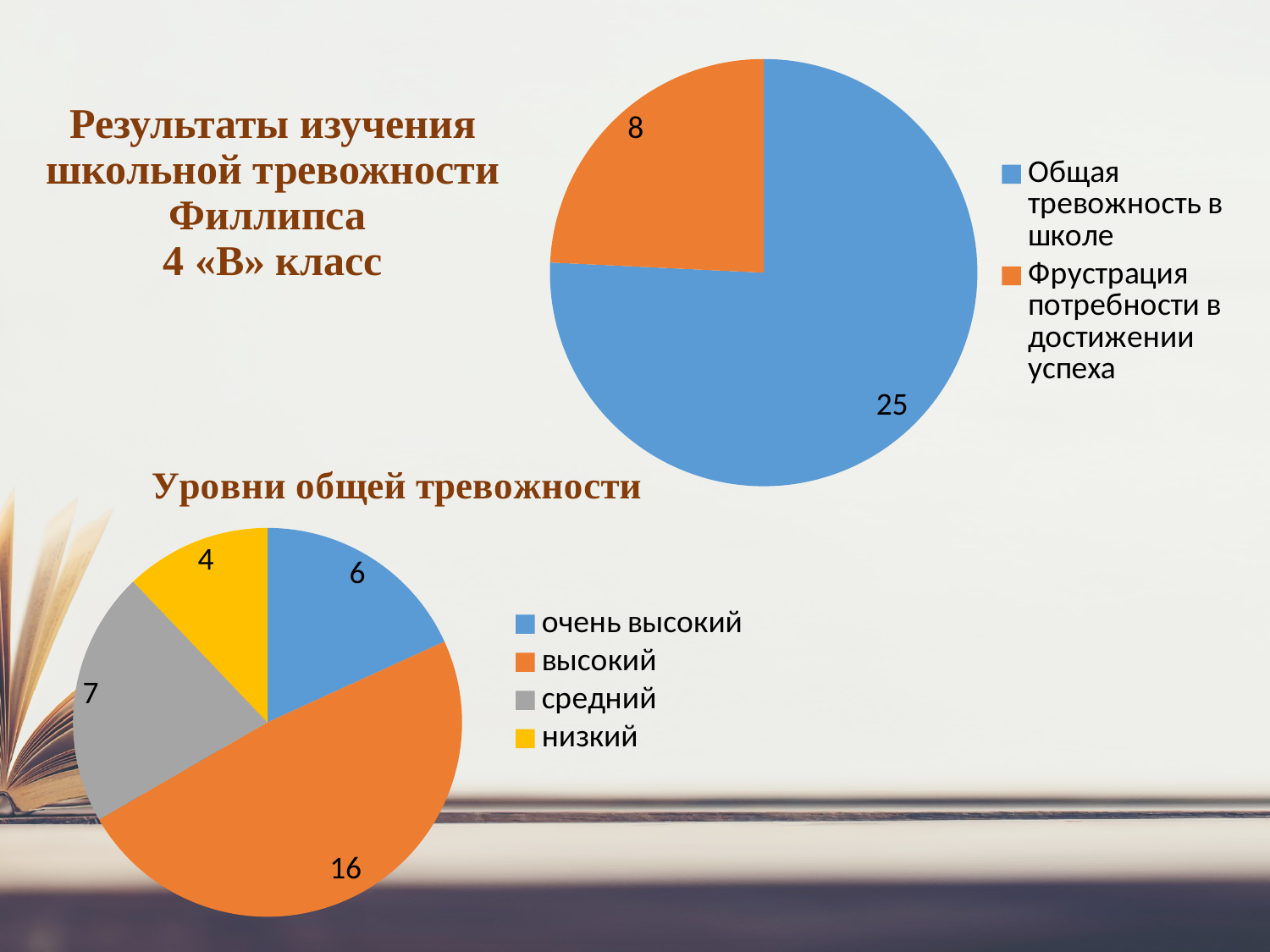
In the top-right pie chart, what is the value for Общая тревожность в школе? 25 In the top-right pie chart, what is the difference between the two slices? 17 In the chart titled Уровни общей тревожности, what is the difference between высокий and средний? 9 In the chart titled Уровни общей тревожности, what is the value for высокий? 16 In the top-right pie chart, what is the value for Фрустрация потребности в достижении успеха? 8 In the chart titled Уровни общей тревожности, which category has the largest slice? высокий In the chart titled Уровни общей тревожности, which category has the smallest slice? низкий In the top-right pie chart, how many slices are there? 2 What kind of chart is the chart titled Уровни общей тревожности? Pie chart In the chart titled Уровни общей тревожности, which is larger: средний or очень высокий? средний In the chart titled Уровни общей тревожности, what is the value for низкий? 4 How many entries does the legend of the chart titled Уровни общей тревожности list? 4